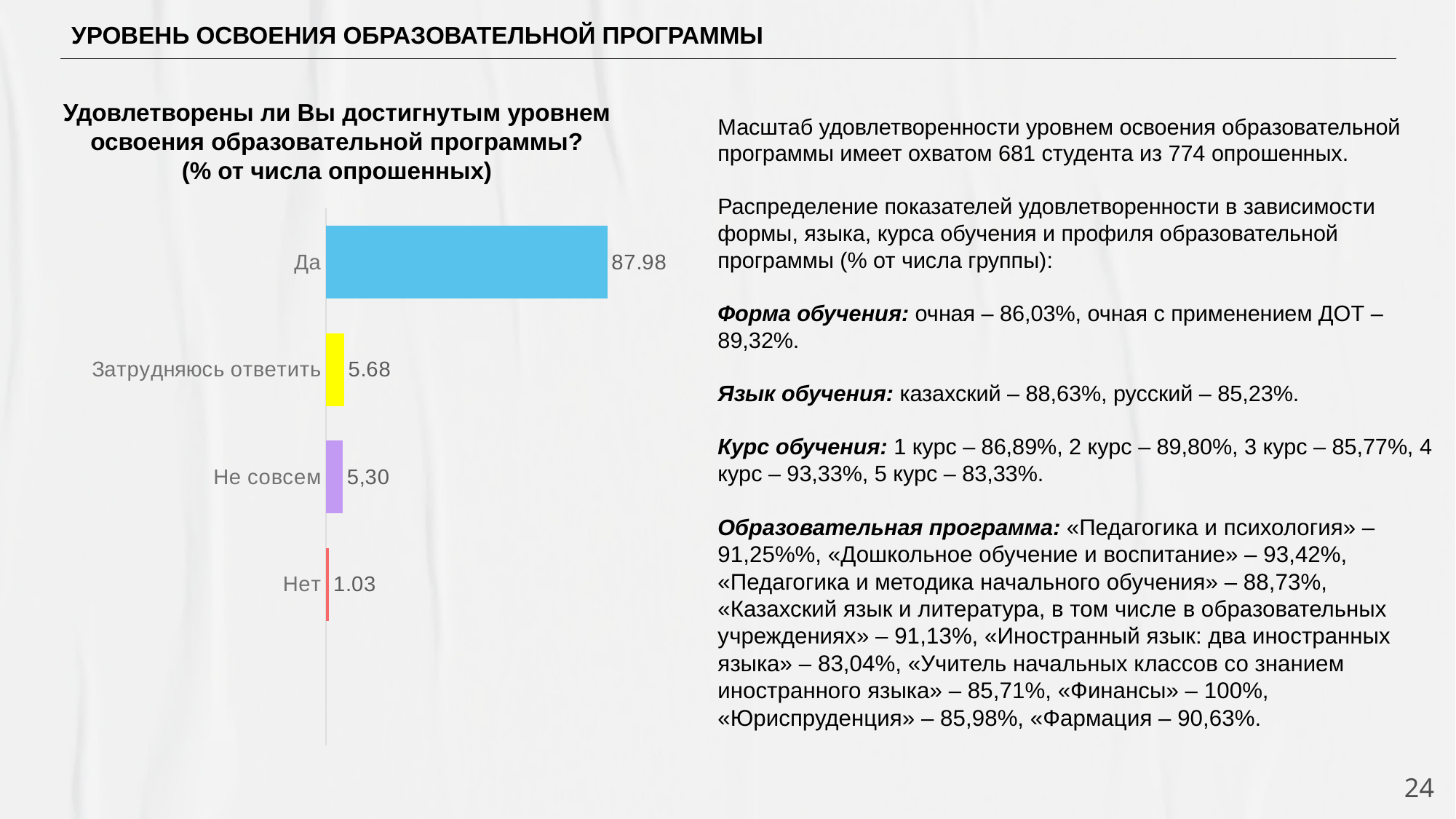
What is the difference between the values for "Да" and "Нет"? 86.95 What is the value for "Не совсем" in the chart? 5,30 Which is larger: the value for "Затрудняюсь ответить" or the value for "Не совсем"? Затрудняюсь ответить How many categories are shown in the chart? 4 What colour is the bar for "Да"? Blue What kind of chart is shown on the slide? Bar chart What is the difference between the values for "Да" and "Затрудняюсь ответить"? 82.30 What is the value for "Да" in the chart? 87.98 Which category has the highest value in the chart? Да What is the value for "Затрудняюсь ответить" in the chart? 5.68 What is the value for "Нет" in the chart? 1.03 Which category has the lowest value in the chart? Нет